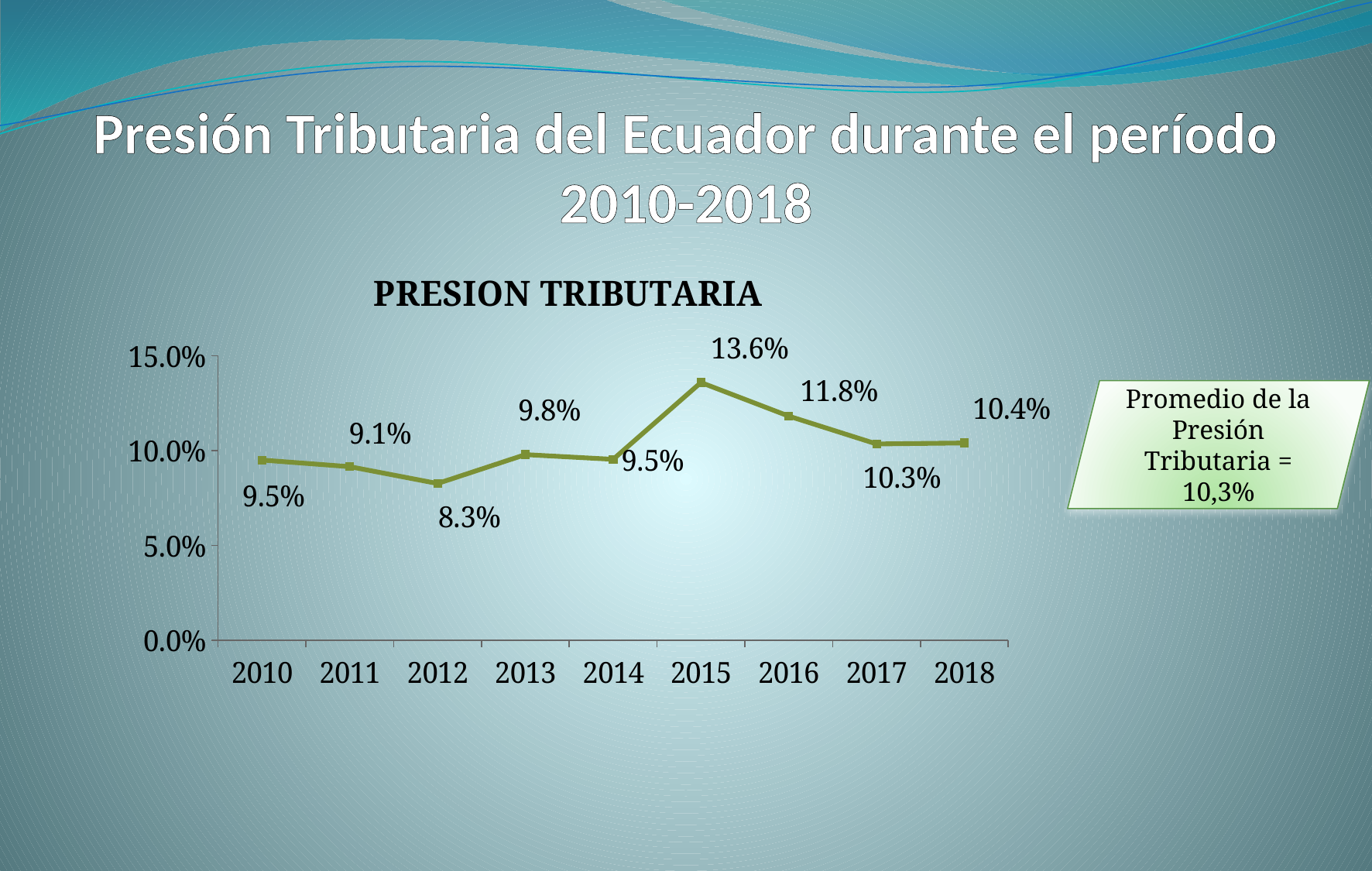
Which year has the lowest value? 2012 What is the value for 2018? 10.4% What is the title of the chart? PRESION TRIBUTARIA Which year has the highest value? 2015 What kind of chart is shown? line chart How many years are plotted on the chart? 9 What is the difference between the values for 2015 and 2016? 1.8% Which is larger, the value for 2013 or the value for 2011? 2013 Do the values rise or fall from 2015 to 2017? fall What is the value for 2012? 8.3% Is the value for 2016 greater or less than 10.0%? greater What is the value for 2015? 13.6%